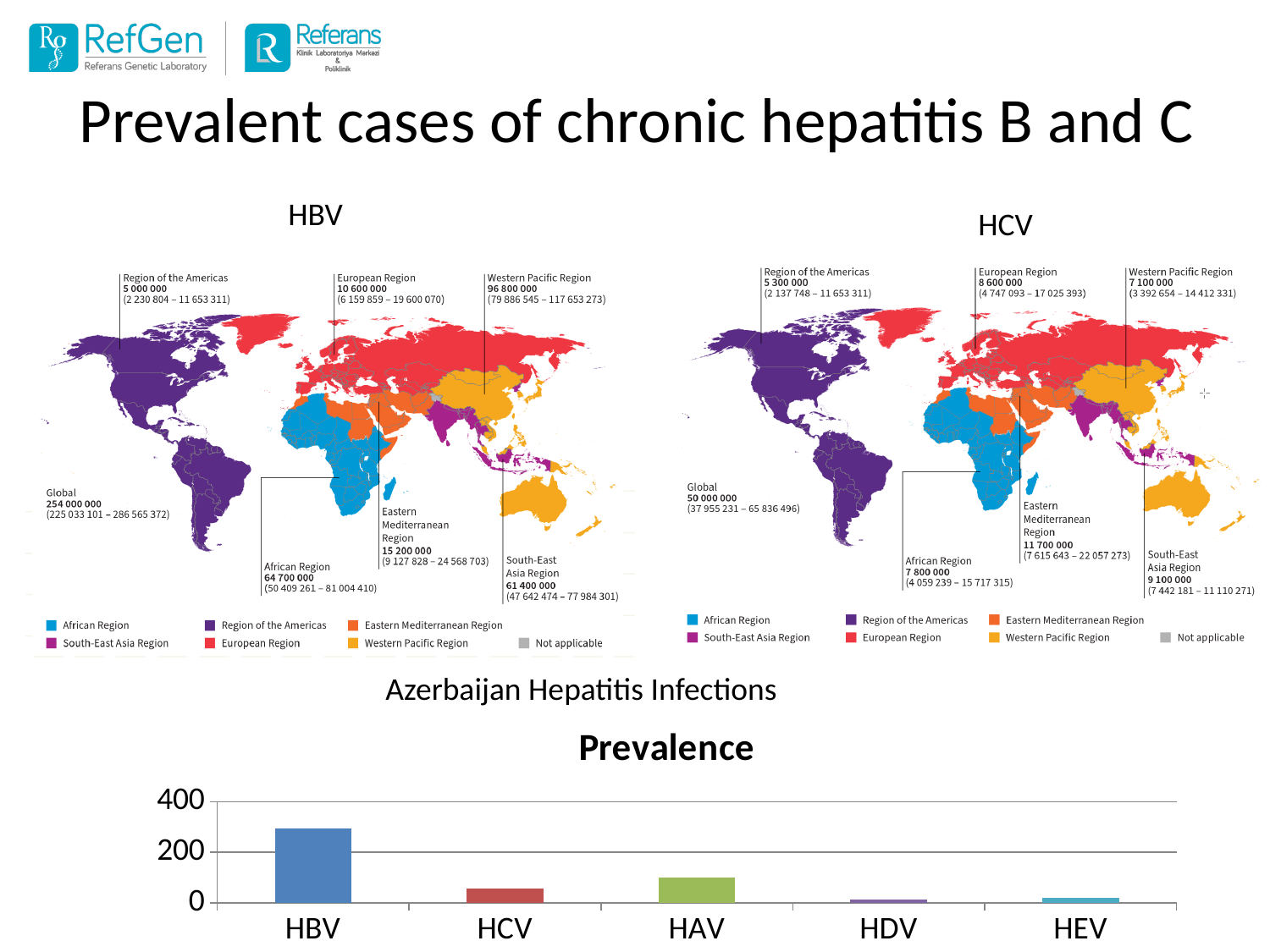
In the 'Prevalence' bar chart, which category has the highest value? HBV In the 'Prevalence' bar chart, is the value for HBV greater or less than 200? greater In the 'Prevalence' bar chart, which is larger, the value for HAV or the value for HCV? HAV On the HCV map, what is the number of prevalent cases shown for the European Region? 8 600 000 How many categories are shown on the x axis of the 'Prevalence' bar chart? 5 On the HBV map, what is the Global number of prevalent cases shown? 254 000 000 What kind of chart is the 'Prevalence' chart at the bottom of the slide? bar chart In the 'Prevalence' bar chart, is the value for HBV greater or less than 400? less What is the title of the bar chart at the bottom of the slide? Prevalence In the 'Prevalence' bar chart, which is larger, the value for HBV or the value for HEV? HBV What heading appears directly above the 'Prevalence' bar chart? Azerbaijan Hepatitis Infections In the 'Prevalence' bar chart, is the value for HAV greater or less than 200? less